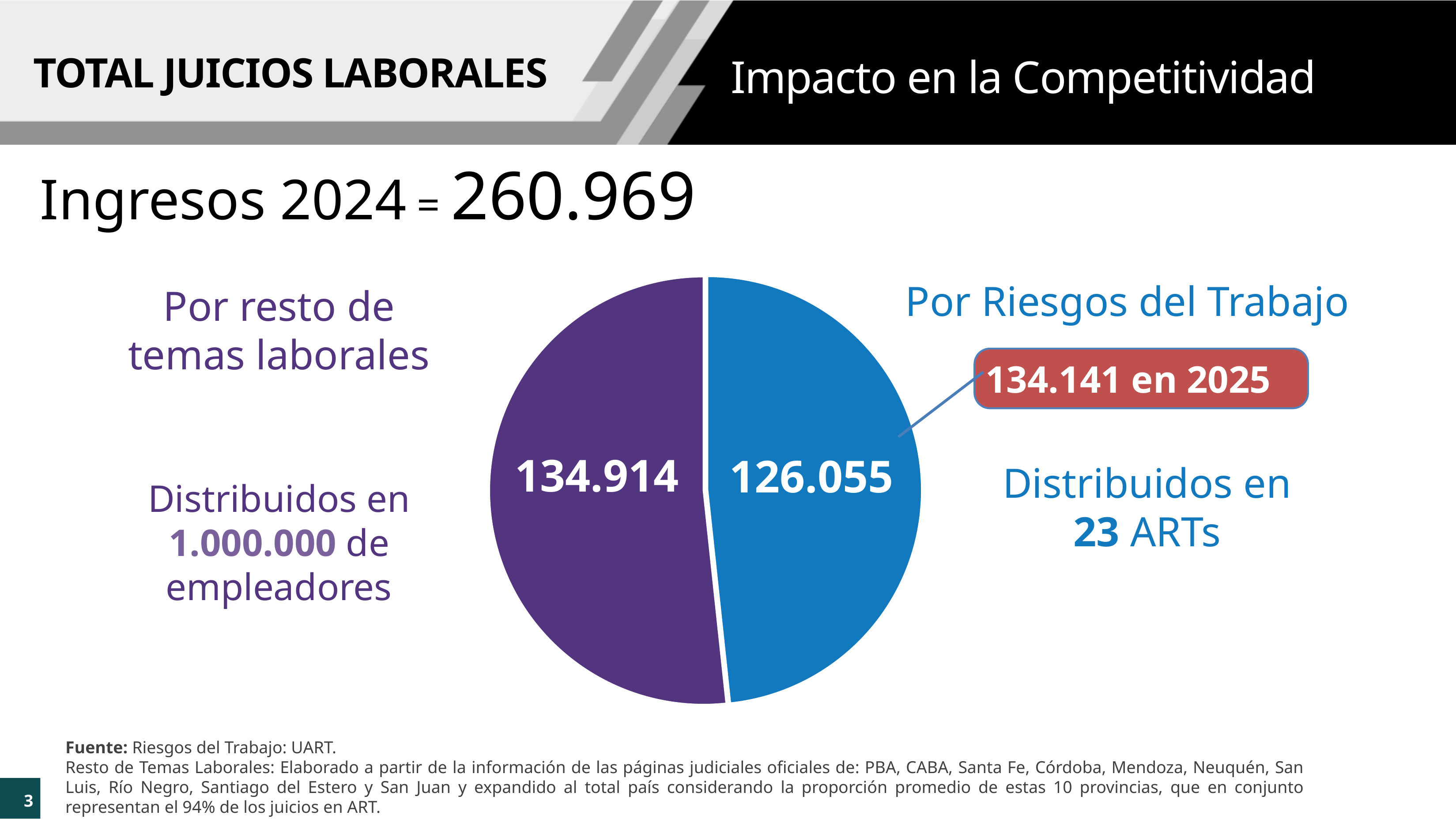
What is the total of the two slices in the pie chart (Ingresos 2024)? 260.969 Which is larger, the 'Por Riesgos del Trabajo' slice or the 'Por resto de temas laborales' slice? Por resto de temas laborales What kind of chart is shown on the slide? pie chart Which slice of the pie chart is the largest? Por resto de temas laborales How many slices does the pie chart have? 2 Which slice of the pie chart is the smallest? Por Riesgos del Trabajo What is the difference between the 'Por resto de temas laborales' slice and the 'Por Riesgos del Trabajo' slice? 8.859 What is the value of the 'Por resto de temas laborales' slice? 134.914 What colour is the 'Por Riesgos del Trabajo' slice? blue What value does the red callout attached to the 'Por Riesgos del Trabajo' slice show? 134.141 en 2025 What is the value of the 'Por Riesgos del Trabajo' slice? 126.055